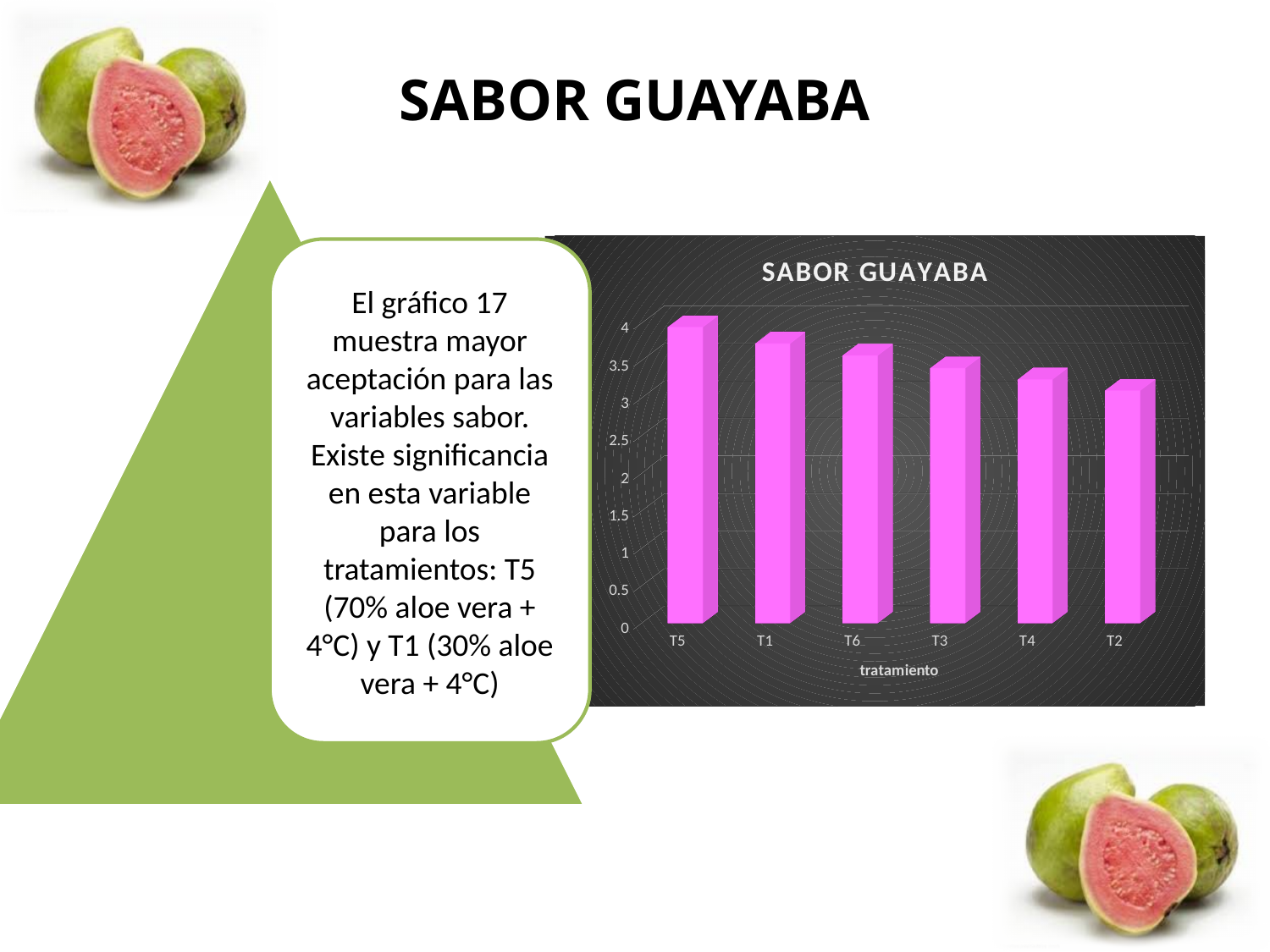
Is the value for T2 greater or less than 3.5? less Do the bar values rise or fall from left to right along the x axis? fall What is the title of the chart? SABOR GUAYABA Which has the larger value, T1 or T4? T1 Which treatment has the highest bar in the chart? T5 Is the value for T5 greater or less than 3.5? greater Is the value for T6 greater or less than 3? greater What is the label of the x axis of the chart? tratamiento Which treatment has the lowest bar in the chart? T2 What kind of chart is shown on the slide? bar chart How many treatments (categories) are plotted on the x axis of the chart? 6